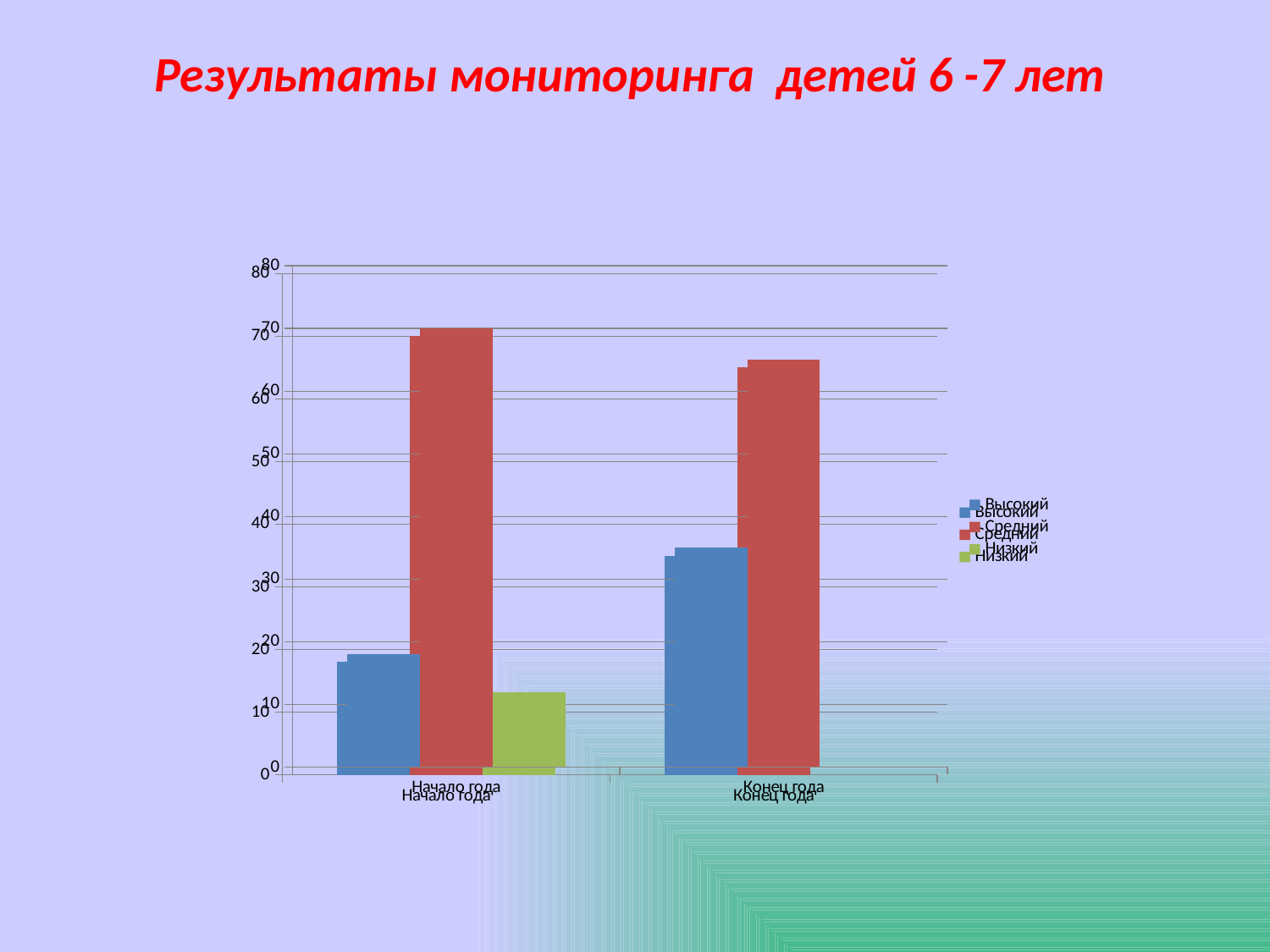
How many categories are shown on the x axis? 2 Which colour represents the Низкий series in the legend? green Is the value for Низкий at Начало года greater or less than 20? less What kind of chart is shown on the slide? bar chart Which is larger for Высокий: the value at Начало года or at Конец года? Конец года Which series has the highest value for Начало года? Средний Does the value for Средний rise or fall from Начало года to Конец года? fall Which series has the lowest value for Начало года? Низкий Is the value for Средний at Начало года greater or less than 60? greater Which series has the highest value for Конец года? Средний How many series does the legend list? 3 Is the value for Высокий at Конец года greater or less than 30? greater